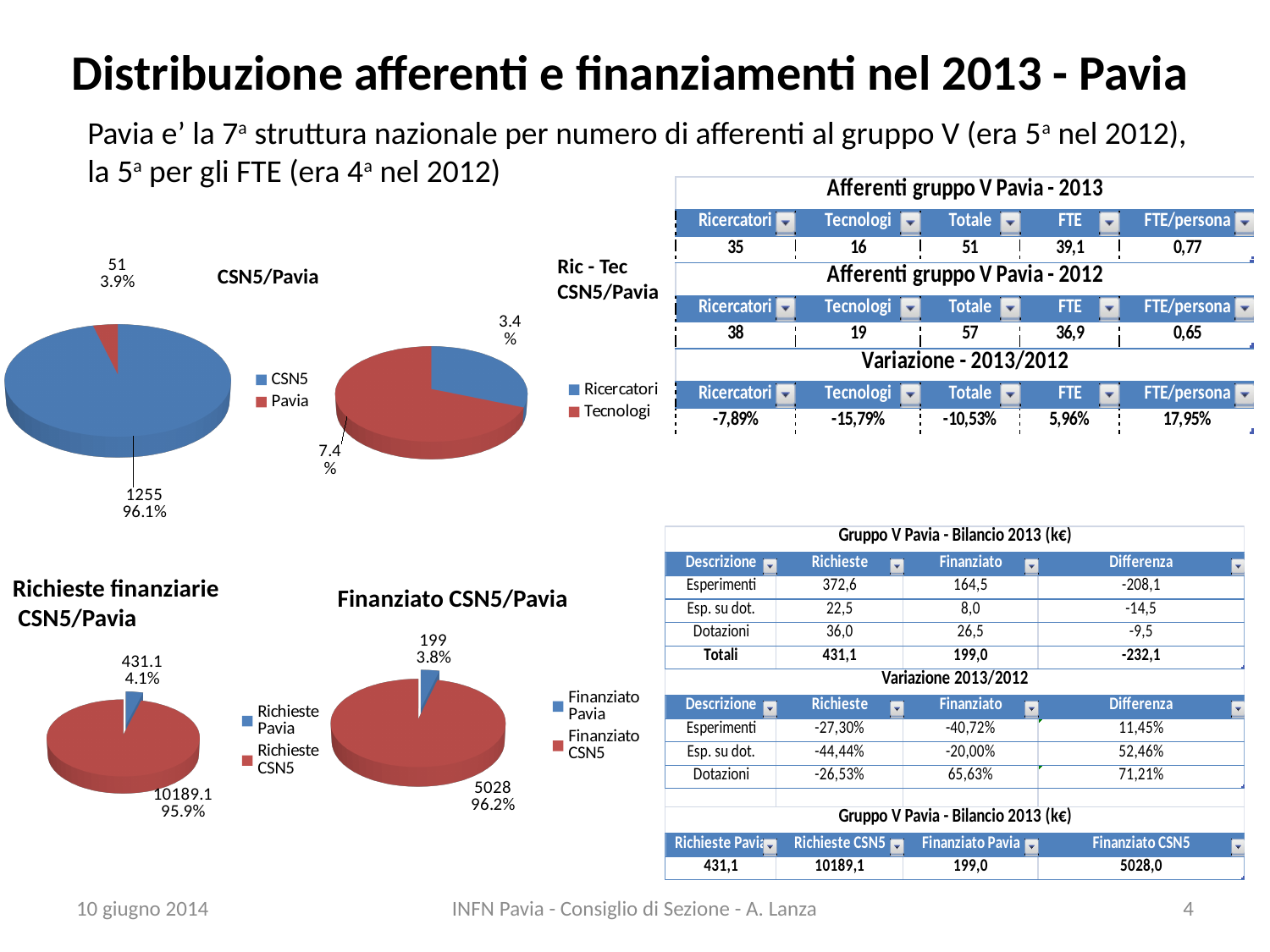
In the 'CSN5/Pavia' pie chart, what value is shown for Pavia? 51 In the 'Finanziato CSN5/Pavia' pie chart, which slice is the smallest? Finanziato Pavia In the 'Richieste finanziarie CSN5/Pavia' pie chart, what value is shown for Richieste Pavia? 431.1 How many entries does the legend of the 'Ric - Tec CSN5/Pavia' chart list? 2 In the 'Richieste finanziarie CSN5/Pavia' pie chart, what share of the pie does Richieste CSN5 have? 95.9% In the 'Finanziato CSN5/Pavia' pie chart, what value is shown for Finanziato Pavia? 199 In the 'CSN5/Pavia' pie chart, what share of the pie does CSN5 have? 96.1% In the 'Finanziato CSN5/Pavia' pie chart, what share of the pie does Finanziato Pavia have? 3.8% In the 'Finanziato CSN5/Pavia' pie chart, what value is shown for Finanziato CSN5? 5028 In the 'Richieste finanziarie CSN5/Pavia' pie chart, which slice is larger, Richieste Pavia or Richieste CSN5? Richieste CSN5 What kind of chart is the 'Ric - Tec CSN5/Pavia' chart? Pie chart In the 'CSN5/Pavia' pie chart, what value is shown for CSN5? 1255